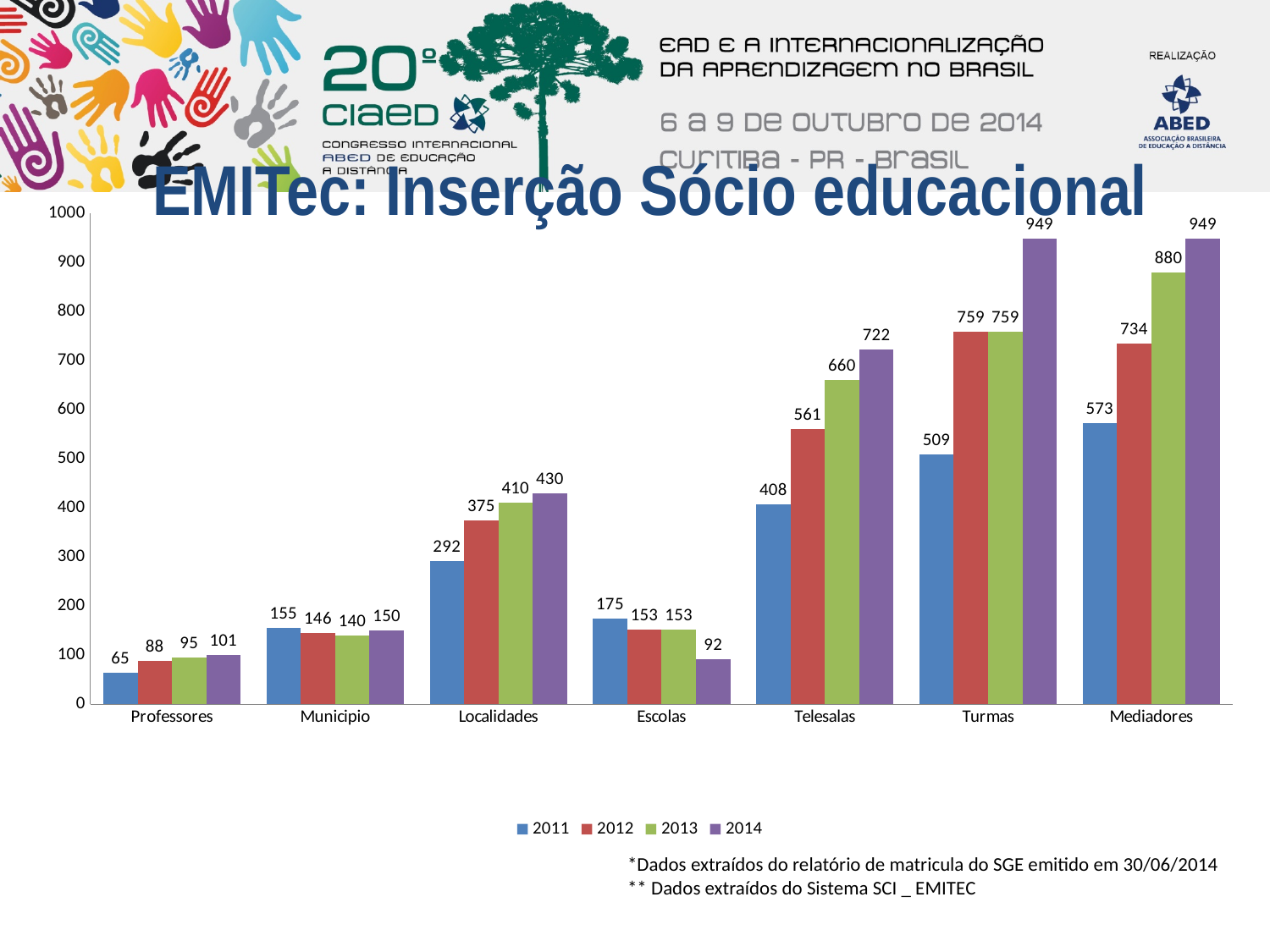
What is the title of the chart? EMITec: Inserção Sócio educacional What is the value for Professores in 2014? 101 How many series does the legend list? 4 Which is larger, the 2012 value for Turmas or the 2012 value for Mediadores? Turmas How many categories are shown on the x axis? 7 What is the difference between the 2014 and 2011 values for Localidades? 138 What is the value for Telesalas in 2012? 561 Which category has the lowest value in the 2011 series? Professores Do the values for Escolas rise or fall from 2011 to 2014? Fall Which category has the highest value in the 2013 series? Mediadores What kind of chart is shown on the slide? Bar chart What is the value for Escolas in 2014? 92